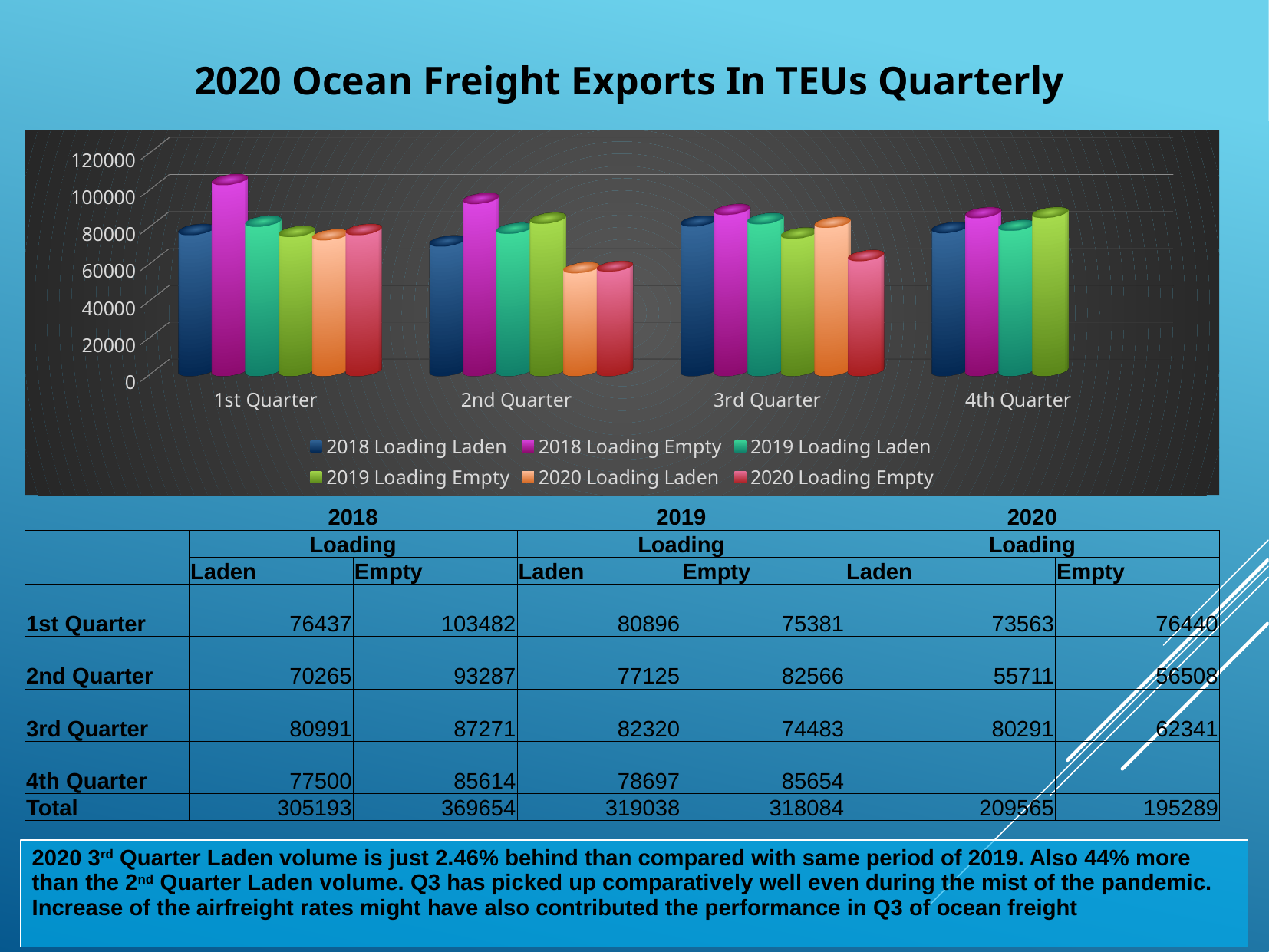
Is the 2018 Loading Empty value for the 1st Quarter greater or less than 100000? greater What kind of chart is shown on the slide? Bar chart What is the 2018 Loading Empty value for the 1st Quarter? 103482 How many series does the chart legend list? 6 In which quarter is the 2020 Loading Laden value lowest? 2nd Quarter Does the 2018 Loading Empty series rise or fall from the 1st Quarter to the 4th Quarter? Falls In which quarter is the 2018 Loading Empty value highest? 1st Quarter In the 2nd Quarter, which is larger: 2019 Loading Laden or 2019 Loading Empty? 2019 Loading Empty How many bars are plotted for the 4th Quarter? 4 What is the difference between 2019 Loading Laden and 2020 Loading Laden in the 3rd Quarter? 2029 How many quarters are shown on the x axis of the chart? 4 What is the 2020 Loading Empty value for the 3rd Quarter? 62341